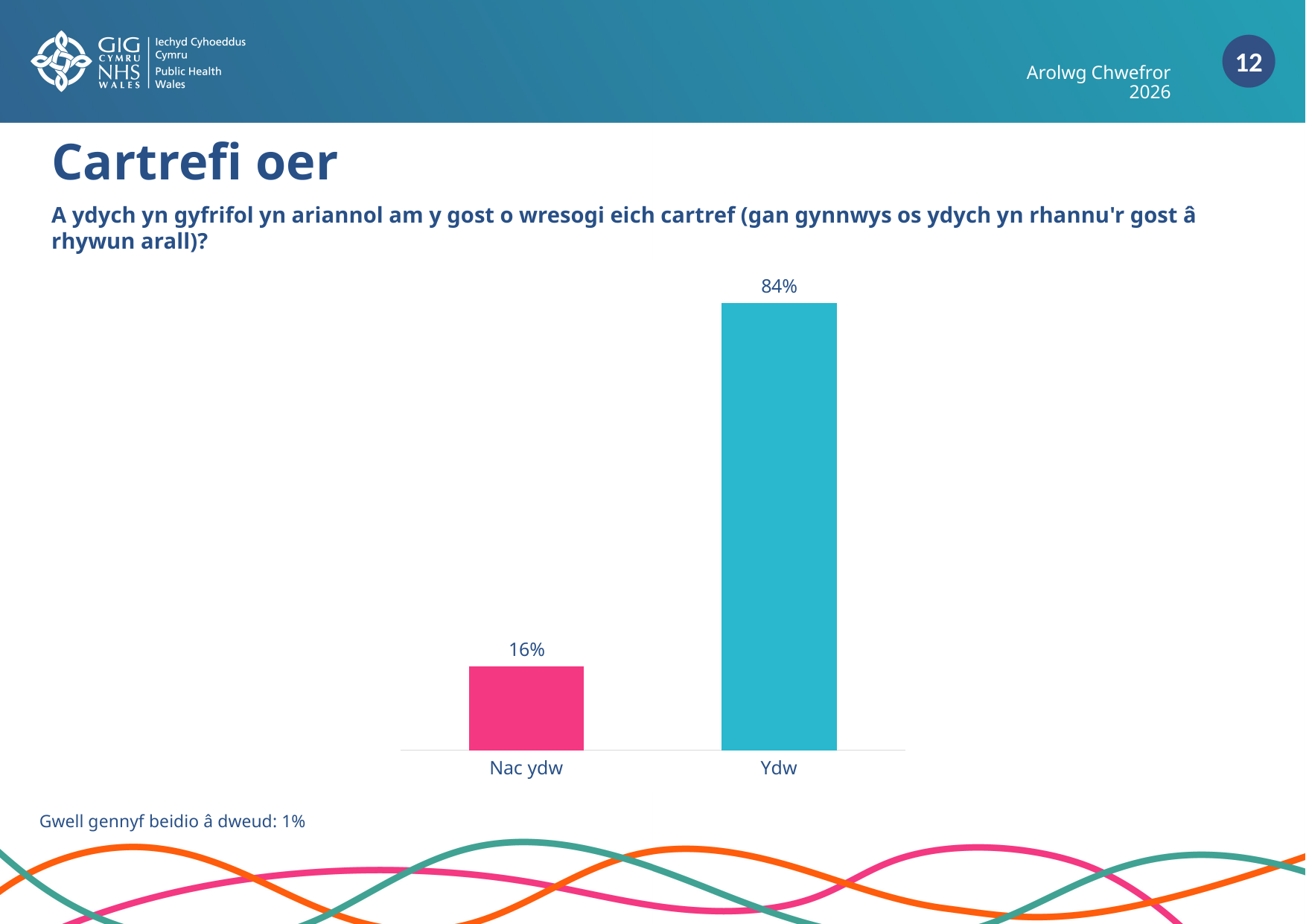
What is the value for Ydw? 84% What kind of chart is shown on the slide? Bar chart Which is larger, the value for Ydw or the value for Nac ydw? Ydw Which category has the lowest value? Nac ydw What percentage is given for 'Gwell gennyf beidio â dweud' below the chart? 1% What is the difference between the values for Ydw and Nac ydw? 68% Which category has the highest value? Ydw What colour is the bar for Nac ydw? Pink What is the total of the two bar values shown in the chart? 100% What is the value for Nac ydw? 16% How many categories are shown on the x axis of the chart? 2